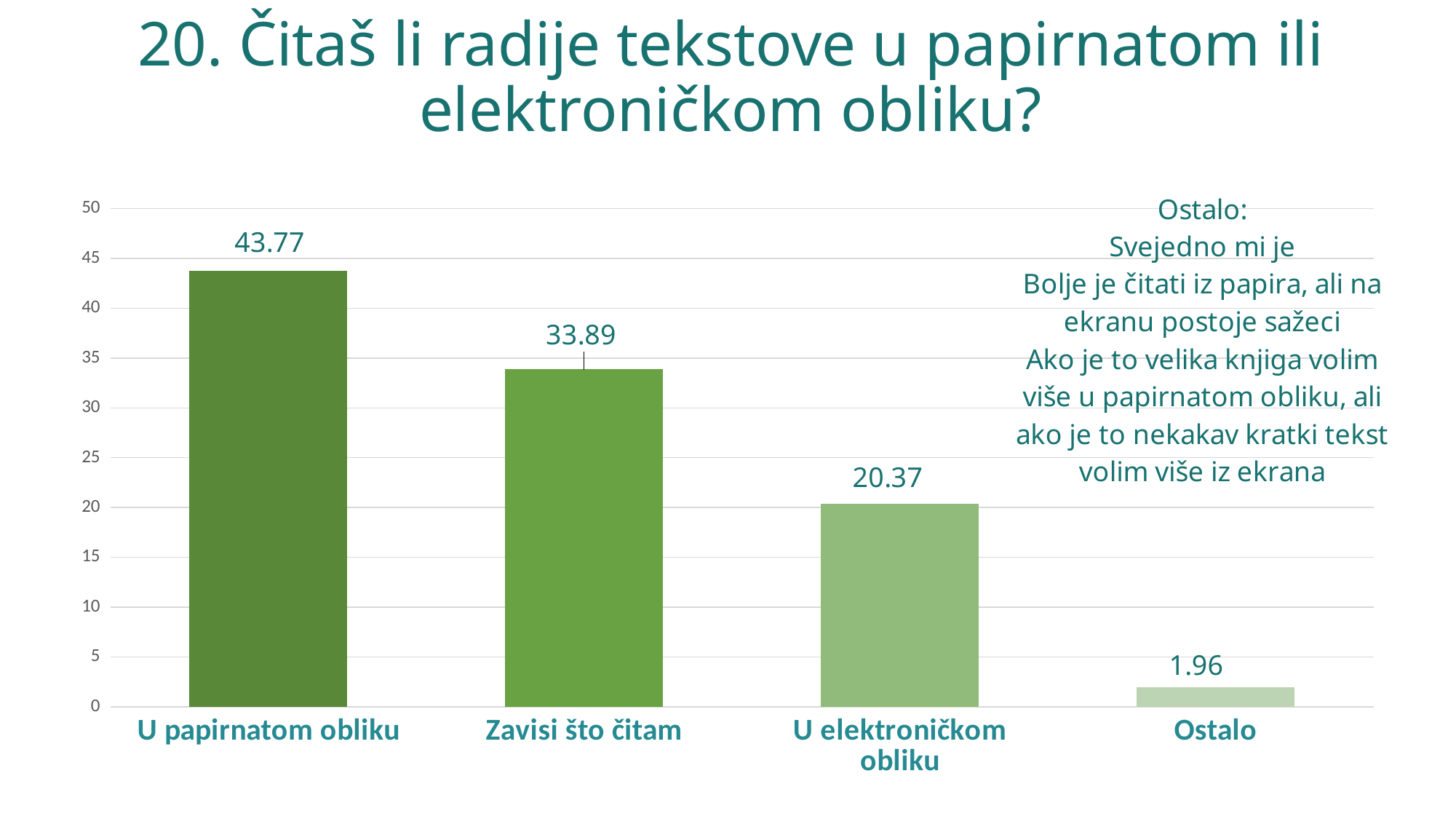
What is the difference between the values for "U papirnatom obliku" and "Zavisi što čitam"? 9.88 Is the value for "U elektroničkom obliku" greater or less than 25? less How many categories are shown on the x axis? 4 What is the value for "Zavisi što čitam"? 33.89 What kind of chart is shown on the slide? bar chart Which category has the lowest value? Ostalo Do the values rise or fall from left to right along the x axis? fall What is the value for "U elektroničkom obliku"? 20.37 What is the value for "Ostalo"? 1.96 Which is larger, the value for "Zavisi što čitam" or the value for "U elektroničkom obliku"? Zavisi što čitam What is the value for "U papirnatom obliku"? 43.77 Which category has the highest value? U papirnatom obliku